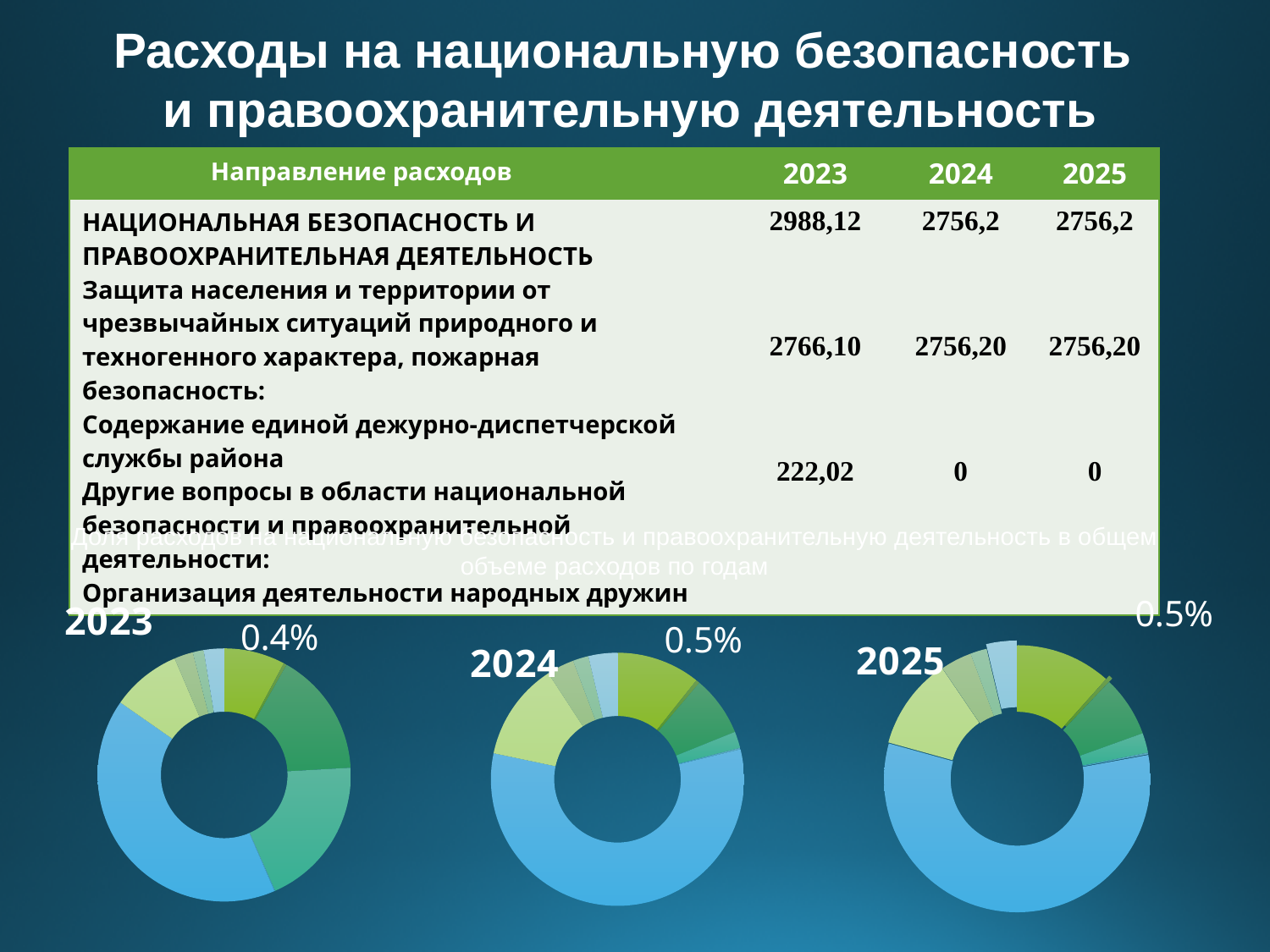
What is the difference between the labelled share in the 2024 doughnut chart and the 2023 doughnut chart? 0.1% What kind of charts are shown at the bottom of the slide? doughnut (pie) charts How does the labelled share change from the 2023 chart to the 2025 chart? rises from 0.4% to 0.5%, then stays at 0.5% How many doughnut charts are shown on the slide? 3 Is the labelled share in the 2024 doughnut chart larger or smaller than in the 2023 doughnut chart? larger Is the labelled share in the 2025 doughnut chart greater or less than 1%? less Which years are the three doughnut charts labelled with? 2023, 2024, 2025 In the 2025 doughnut chart, what share is shown by the data label? 0.5% In the 2023 doughnut chart, what share is shown by the data label? 0.4% In the 2024 doughnut chart, what share is shown by the data label? 0.5% Which year's doughnut chart shows the lowest labelled share for national security and law enforcement expenses? 2023